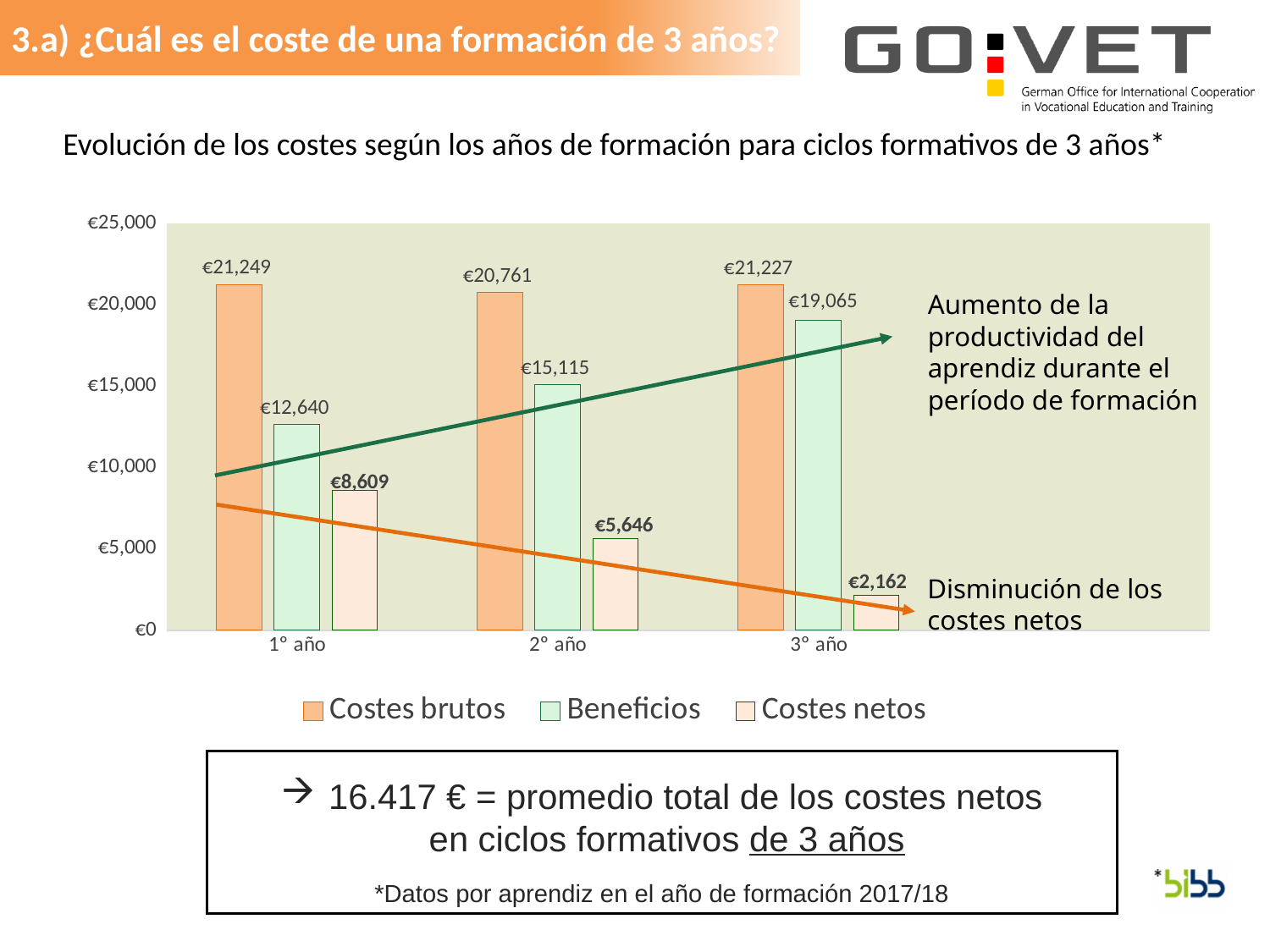
What kind of chart is shown on the slide? bar chart Is the value of Beneficios for 2° año greater or less than €15,000? greater What is the value of Beneficios for 3° año? €19,065 Which year has the highest Beneficios value? 3° año How many series does the legend list? 3 Do the Costes netos values rise or fall from 1° año to 3° año? fall What is the difference between Costes brutos and Beneficios for 2° año? €5,646 How many year categories are shown on the x axis? 3 What is the value of Costes netos for 2° año? €5,646 Which is larger for 1° año: Beneficios or Costes netos? Beneficios Which year has the lowest Costes netos value? 3° año What is the value of Costes brutos for 1° año? €21,249